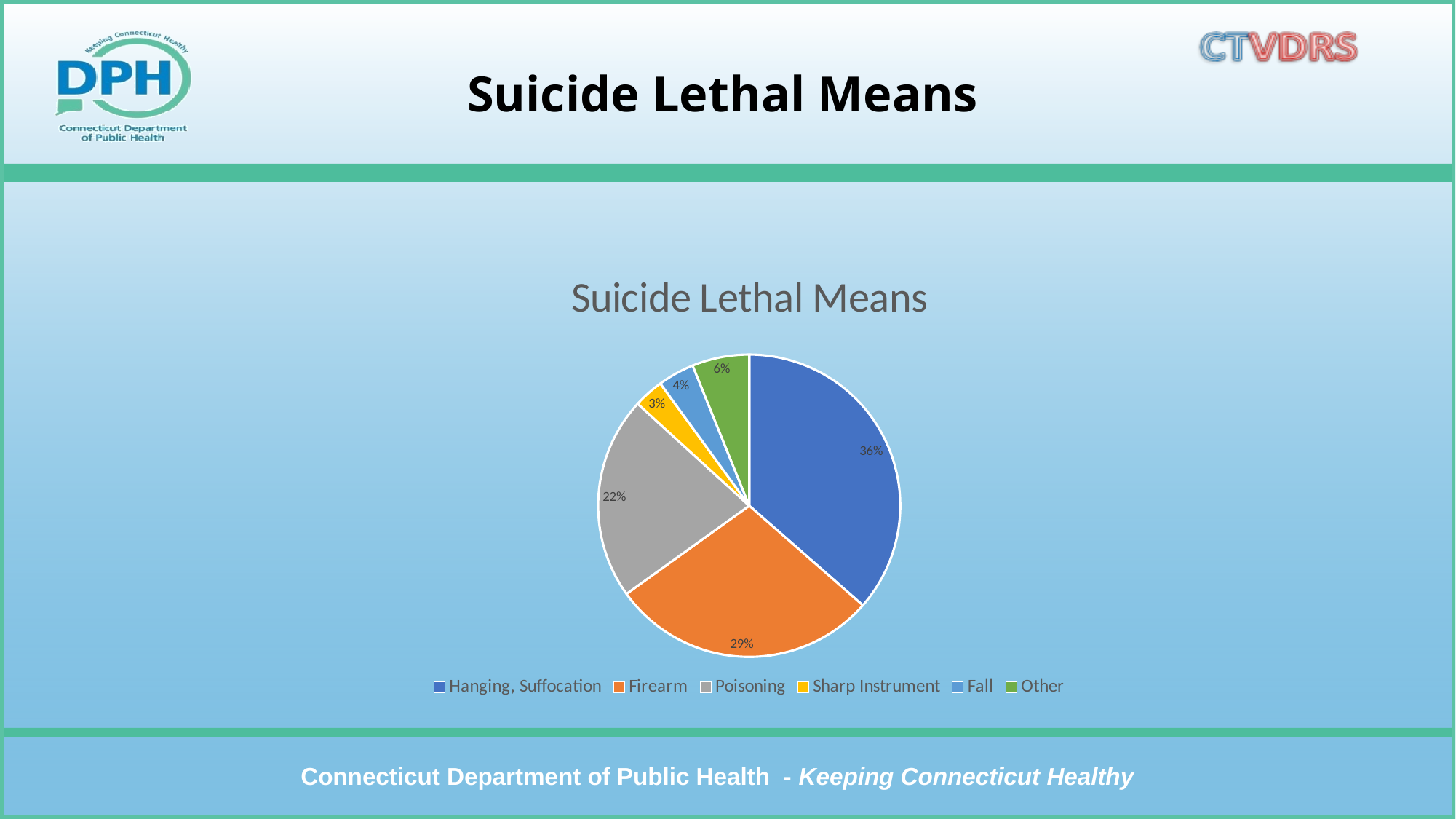
What kind of chart is shown on the slide? pie chart What is the difference in percentage points between Hanging, Suffocation and Firearm? 7 Which is larger, the share for Other or the share for Fall? Other What share of the pie does Firearm account for? 29% How many categories does the legend list? 6 Which category has the largest slice of the pie? Hanging, Suffocation What share of the pie does Fall account for? 4% Which category has the smallest slice of the pie? Sharp Instrument What share of the pie does Hanging, Suffocation account for? 36% What is the title of the chart? Suicide Lethal Means